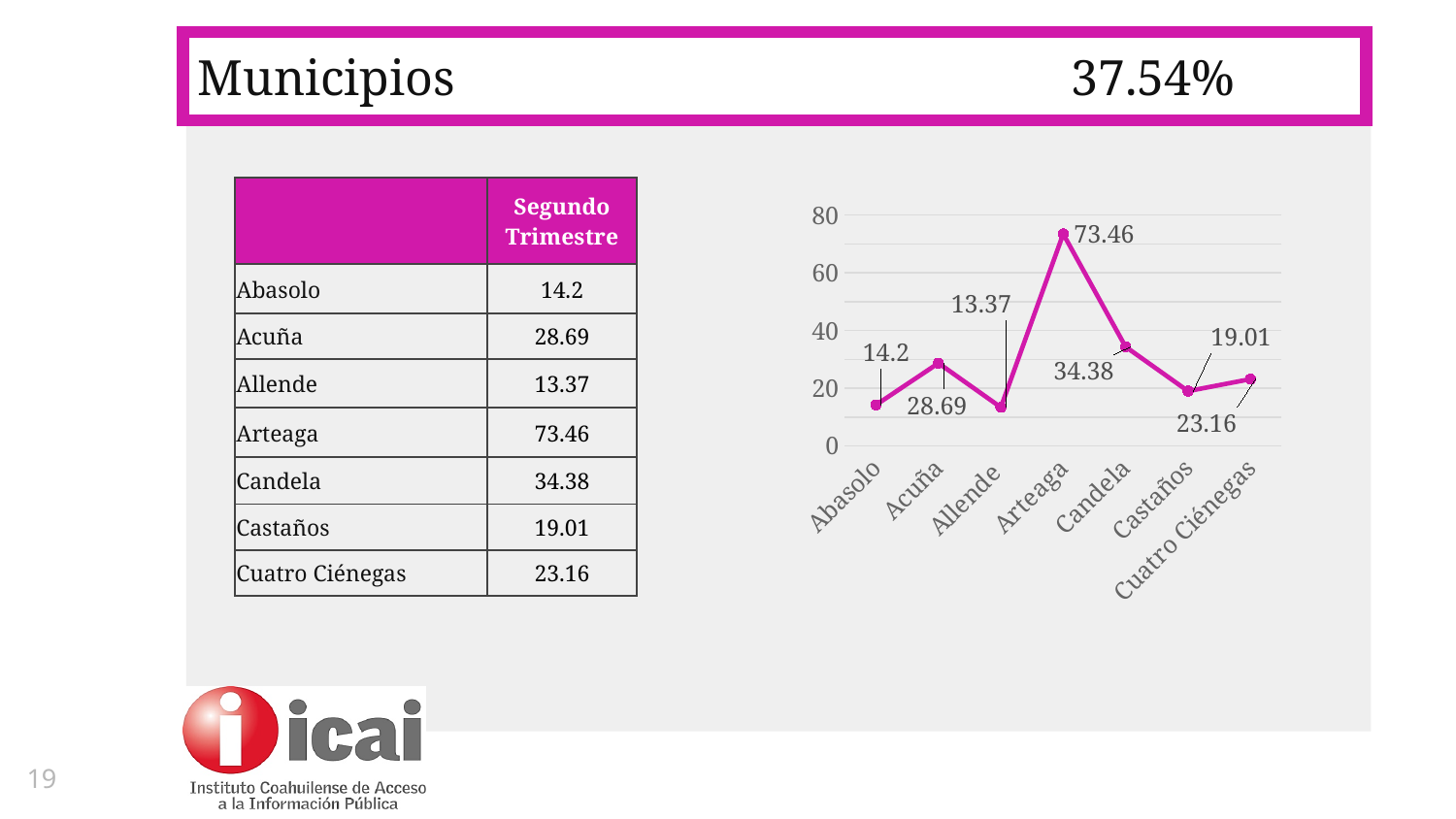
Which municipality has the highest value in the chart? Arteaga Which has a larger value, Castaños or Cuatro Ciénegas? Cuatro Ciénegas What is the value for Candela in the chart? 34.38 What kind of chart is shown on the slide? line chart How many municipalities are plotted in the chart? 7 What is the difference between the values for Acuña and Abasolo? 14.49 What is the difference between the values for Arteaga and Candela? 39.08 Does the line rise or fall from Arteaga to Castaños? fall What is the value for Cuatro Ciénegas in the chart? 23.16 Is the value for Candela greater or less than 40? less What is the value for Arteaga in the chart? 73.46 Which municipality has the lowest value in the chart? Allende